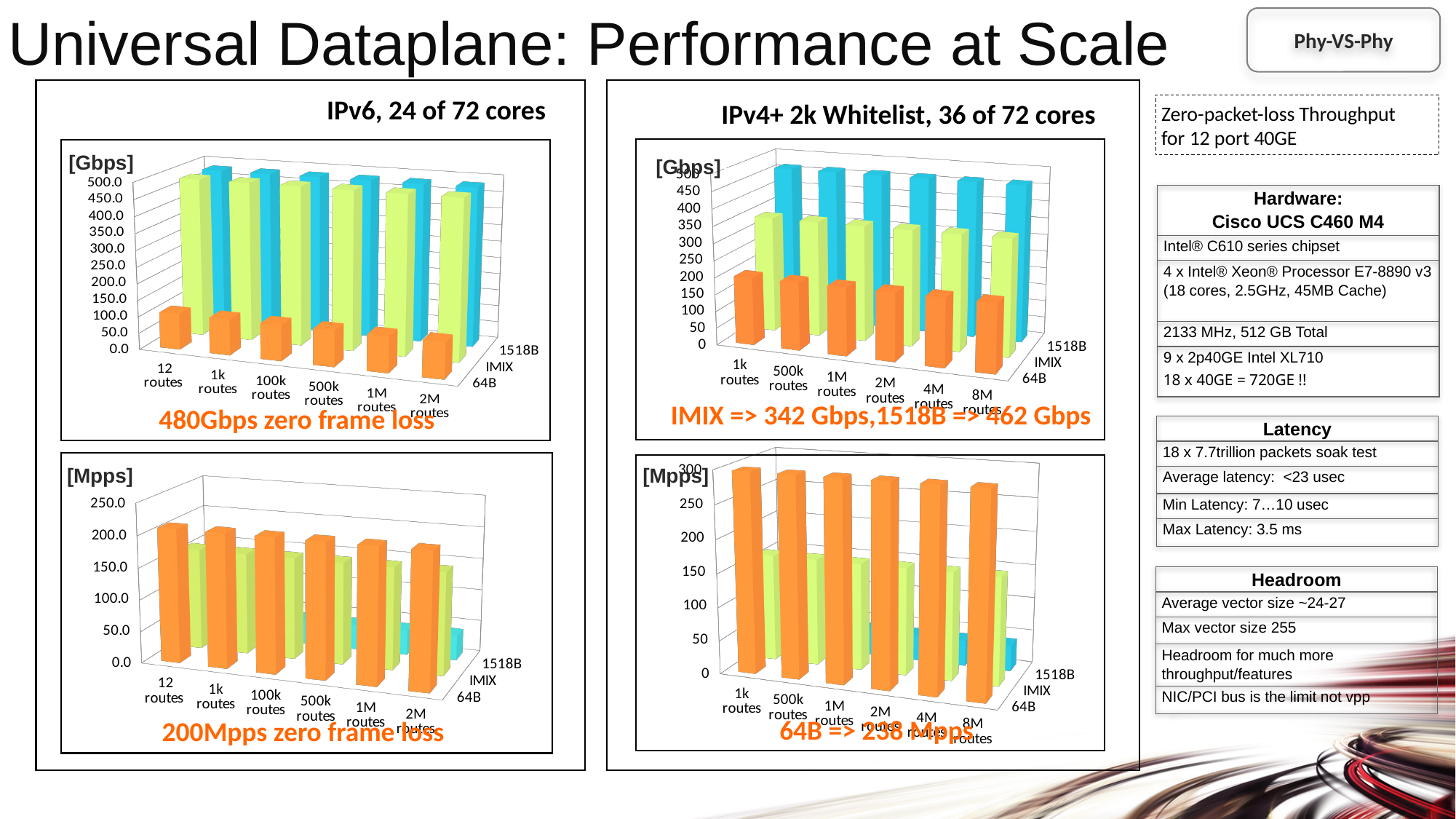
In the top-right chart titled 'IPv4+ 2k Whitelist, 36 of 72 cores', is the 64B value for 1k routes greater or less than 300 Gbps? less In the top-left chart titled 'IPv6, 24 of 72 cores', is the 1518B value for 12 routes greater or less than 400.0 Gbps? greater In the top-left chart titled 'IPv6, 24 of 72 cores', how many series (packet sizes) are plotted? 3 In the top-left chart titled 'IPv6, 24 of 72 cores', which is larger for 12 routes: the 64B value or the 1518B value? 1518B In the bottom-right [Mpps] chart, is the 64B value for 1k routes greater or less than 250 Mpps? greater What unit is shown on the y axis of the bottom-left chart? [Mpps] What kind of chart is the top-right chart titled 'IPv4+ 2k Whitelist, 36 of 72 cores'? bar chart In the bottom-left [Mpps] chart, which is larger for 12 routes: the 64B value or the 1518B value? 64B In the top-left chart titled 'IPv6, 24 of 72 cores', how many route categories are shown on the x axis? 6